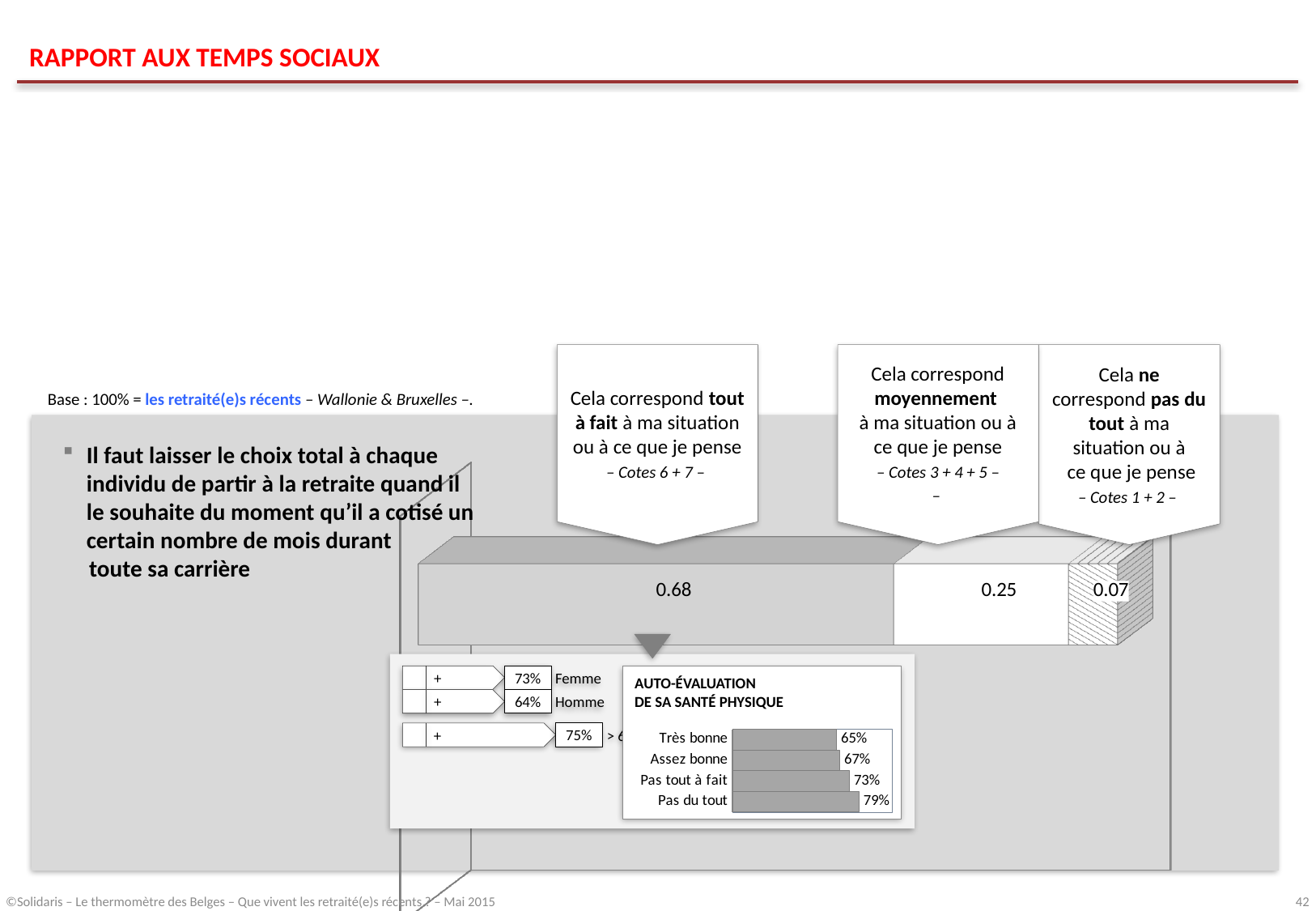
In the stacked bar chart, which segment has the smallest value? Cela ne correspond pas du tout à ma situation ou à ce que je pense What kind of chart is the 'AUTO-ÉVALUATION DE SA SANTÉ PHYSIQUE' chart? Bar chart In the 'AUTO-ÉVALUATION DE SA SANTÉ PHYSIQUE' chart, what is the value for 'Pas du tout'? 79% In the 'AUTO-ÉVALUATION DE SA SANTÉ PHYSIQUE' chart, what is the difference between 'Pas tout à fait' and 'Assez bonne'? 6% In the stacked bar chart, what is the value for the segment 'Cela correspond moyennement à ma situation ou à ce que je pense'? 0.25 In the stacked bar chart, which segment has the largest value? Cela correspond tout à fait à ma situation ou à ce que je pense In the stacked bar chart, how many segments make up the bar? 3 In the stacked bar chart, what is the value for the segment 'Cela ne correspond pas du tout à ma situation ou à ce que je pense'? 0.07 In the 'AUTO-ÉVALUATION DE SA SANTÉ PHYSIQUE' chart, what is the value for 'Très bonne'? 65% In the stacked bar chart, what is the difference between the 'tout à fait' segment (0.68) and the 'moyennement' segment (0.25)? 0.43 In the 'AUTO-ÉVALUATION DE SA SANTÉ PHYSIQUE' chart, which category has the highest value? Pas du tout In the stacked bar chart, what is the value for the segment 'Cela correspond tout à fait à ma situation ou à ce que je pense'? 0.68